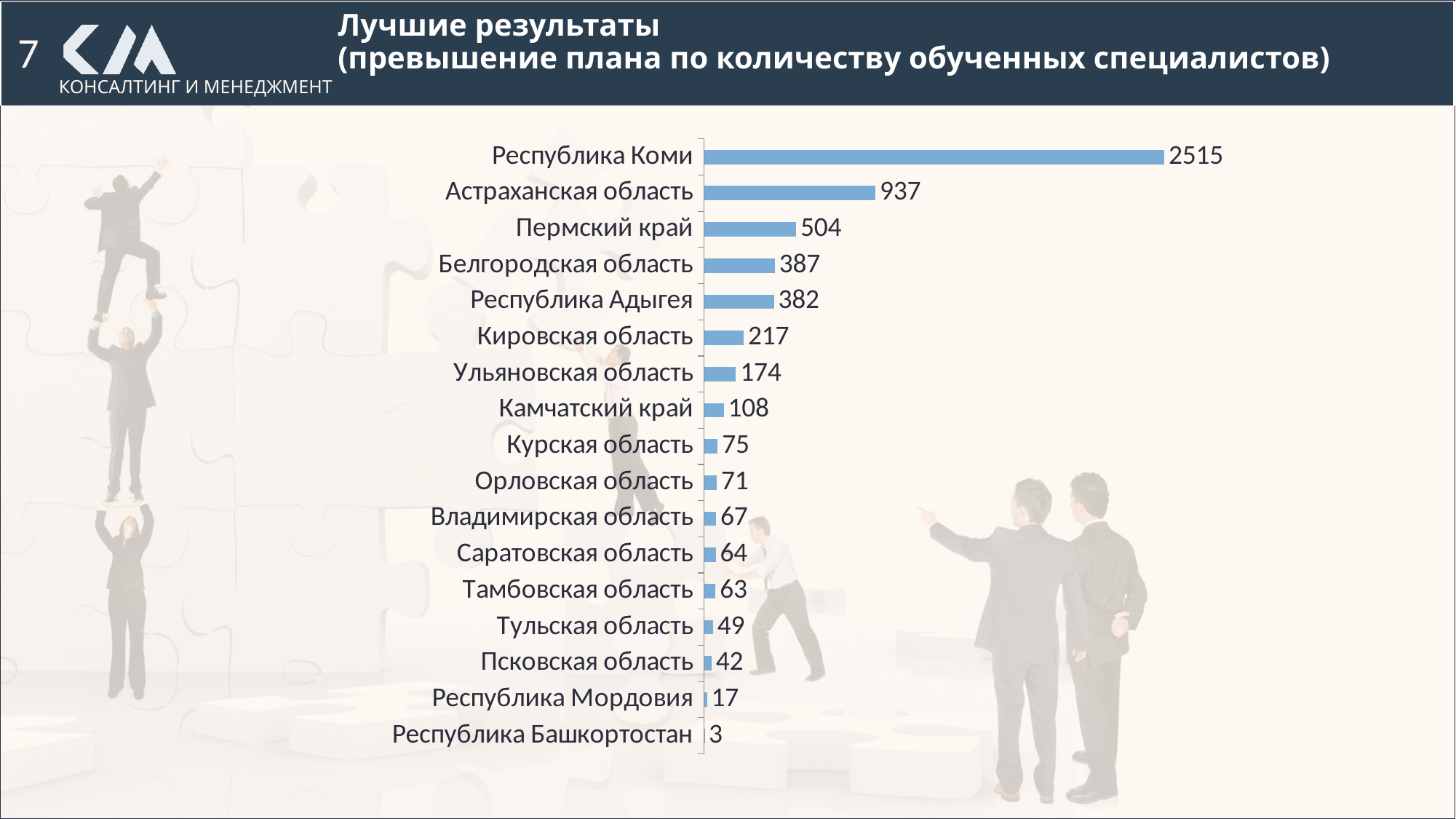
What is the value for Пермский край? 504 Which region has the highest value? Республика Коми What is the value for Камчатский край? 108 What kind of chart is shown on the slide? bar chart What is the value for Республика Мордовия? 17 What is the difference between the values for Республика Коми and Астраханская область? 1578 What is the difference between the values for Белгородская область and Республика Адыгея? 5 What is the value for Республика Коми? 2515 Which region has the lowest value? Республика Башкортостан How many regions are shown in the chart? 17 What is the title of the slide? Лучшие результаты (превышение плана по количеству обученных специалистов) Which is larger, the value for Кировская область or the value for Ульяновская область? Кировская область